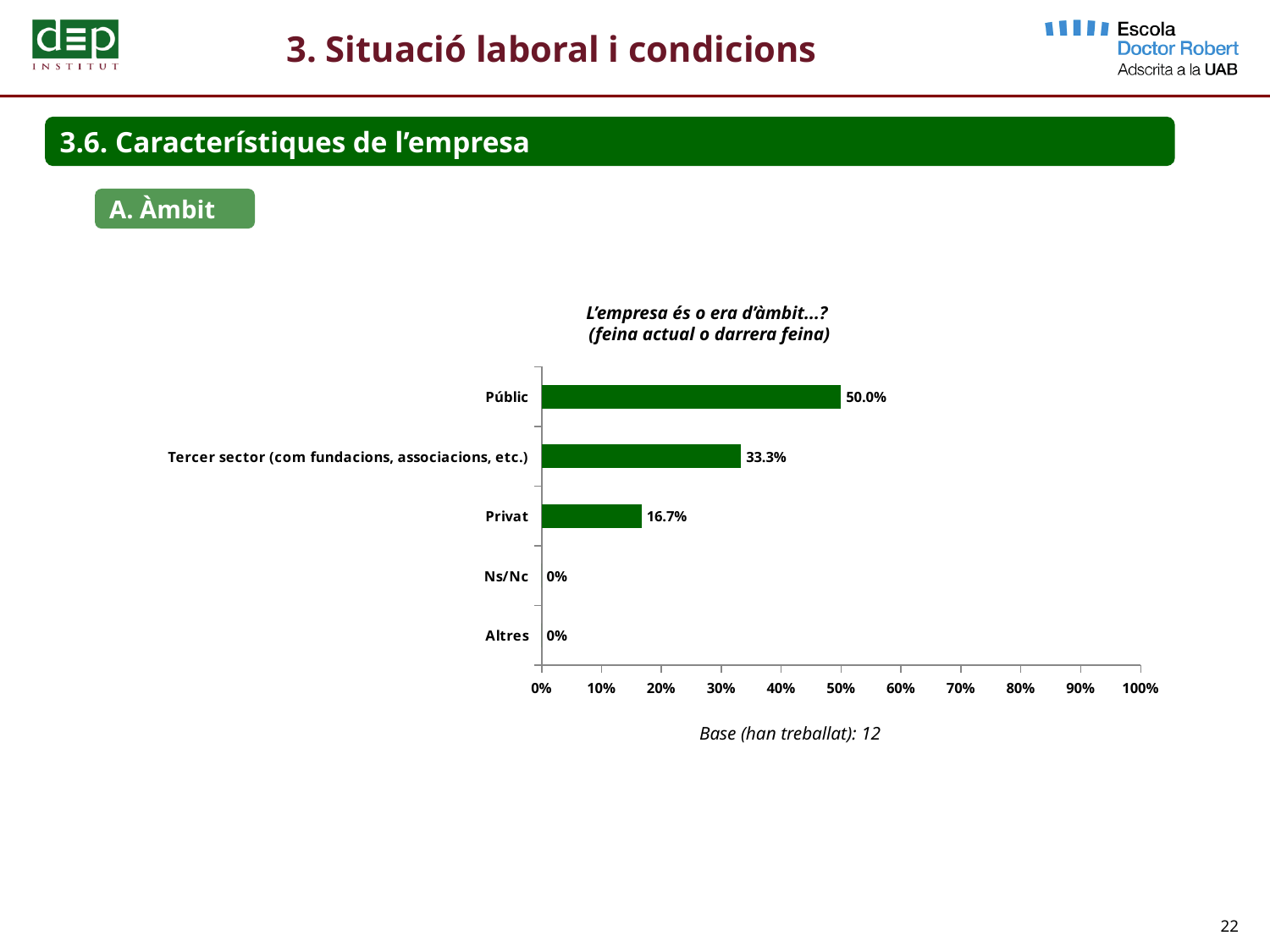
How many categories are shown on the chart? 5 What is the value for Tercer sector (com fundacions, associacions, etc.)? 33.3% What is the difference between the values for Públic and Tercer sector? 16.7% Is the value for Privat greater or less than 20%? less What is the base (number of respondents) stated below the chart? 12 What kind of chart is shown on the slide? bar chart What is the value for Públic? 50.0% Which category has the highest value? Públic What is the value for Ns/Nc? 0% What is the value for Privat? 16.7% Which is larger, the value for Tercer sector or the value for Privat? Tercer sector What is the difference between the values for Públic and Privat? 33.3%